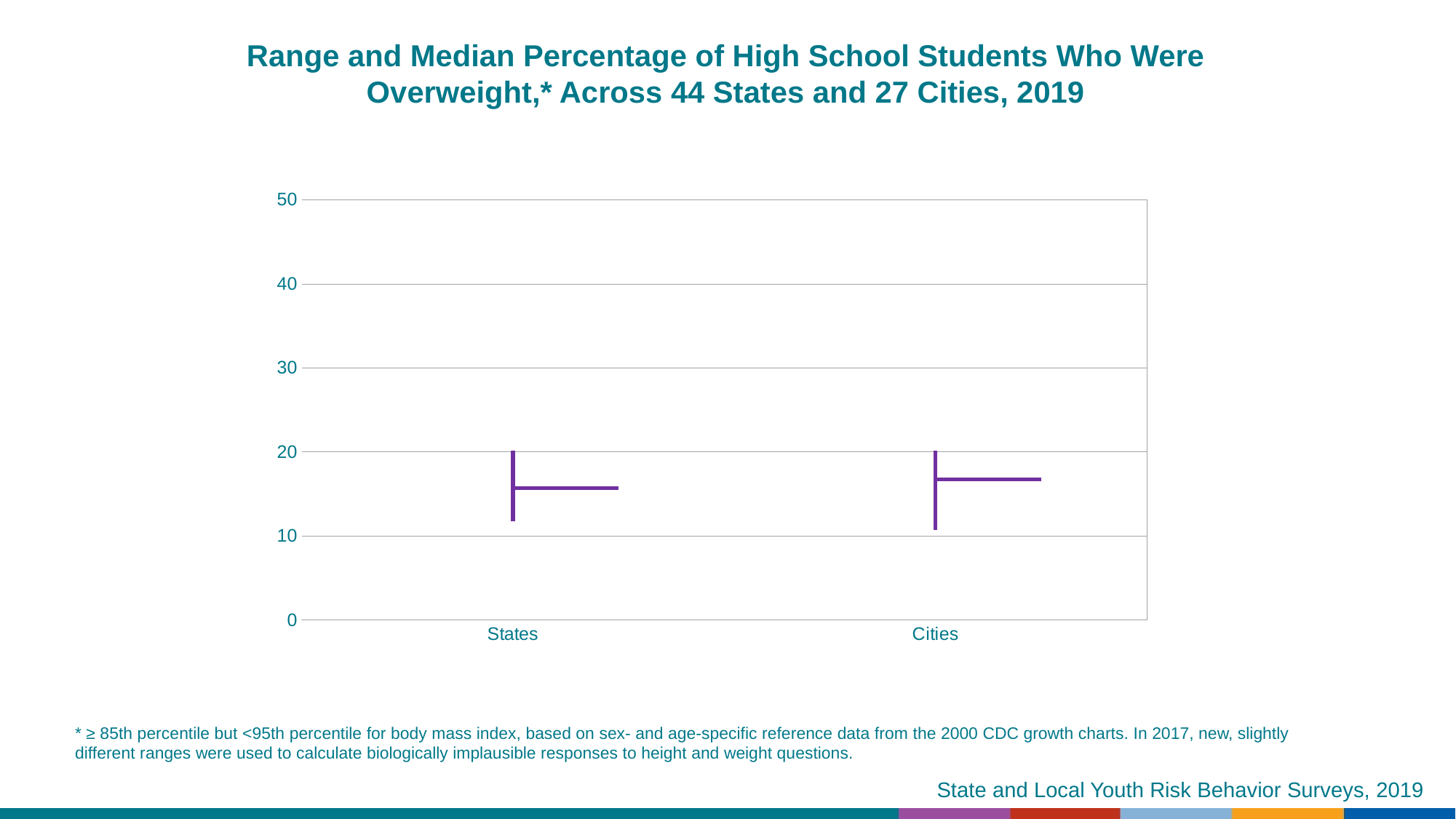
What are the two categories shown on the x axis? States and Cities Which category has the higher median value, States or Cities? Cities Is the lowest value in the States range greater or less than 10? greater Is the median value for States greater or less than 10? greater What is the maximum value shown on the y axis? 50 Is the median value for States greater or less than 20? less According to the title, how many states and how many cities are included in the chart? 44 states and 27 cities How many categories are shown on the x axis of the chart? 2